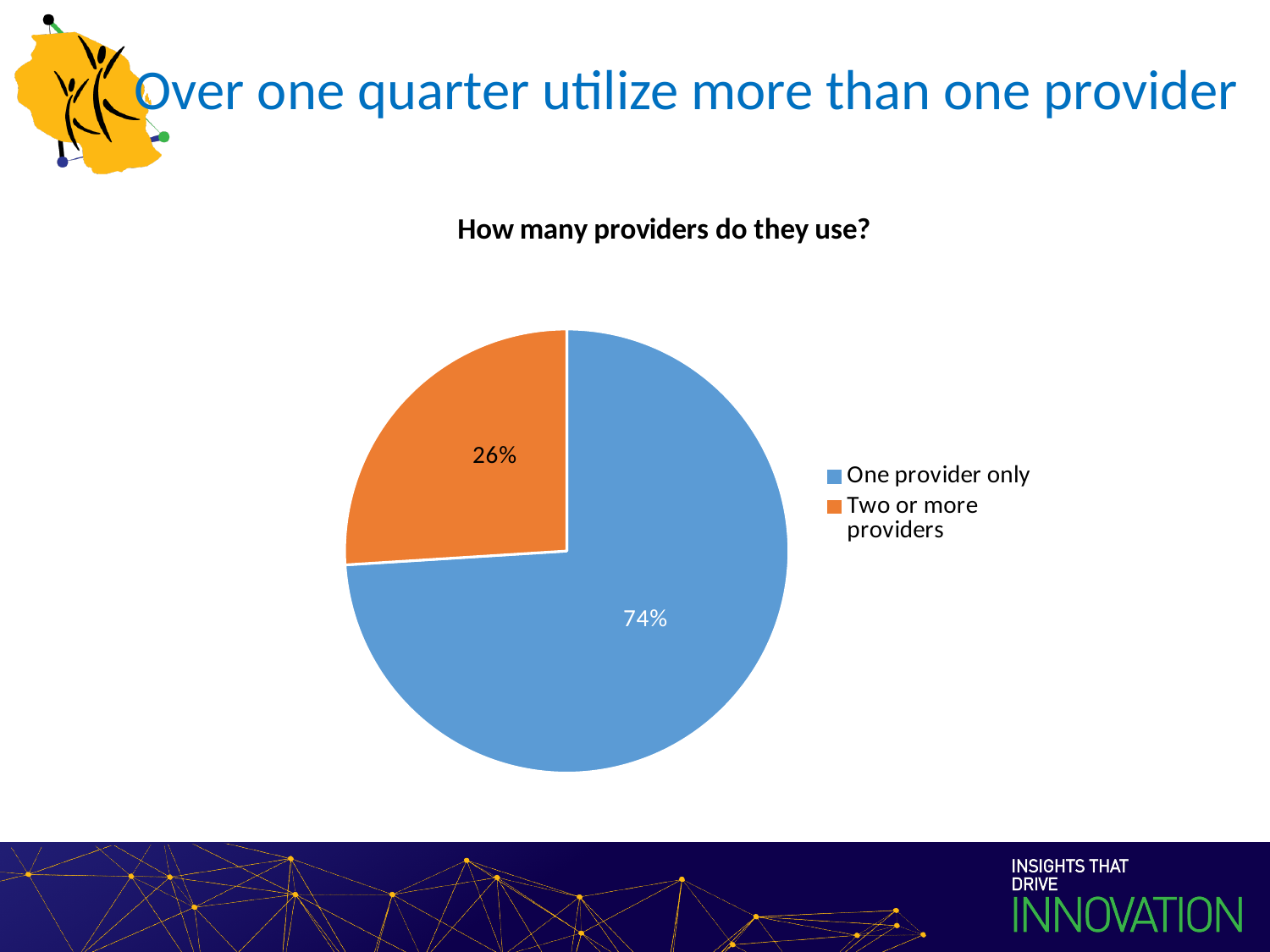
What is the chart's title? How many providers do they use? Which category has the smallest slice of the pie? Two or more providers What colour is the 'Two or more providers' slice? orange What share of the pie is 'Two or more providers'? 26% What kind of chart is shown on the slide? pie chart Which category has the largest slice of the pie? One provider only How many entries does the legend list? 2 What share of the pie is 'One provider only'? 74% Which is larger: the share for 'One provider only' or for 'Two or more providers'? One provider only How many categories does the pie chart show? 2 What is the difference in percentage points between 'One provider only' and 'Two or more providers'? 48